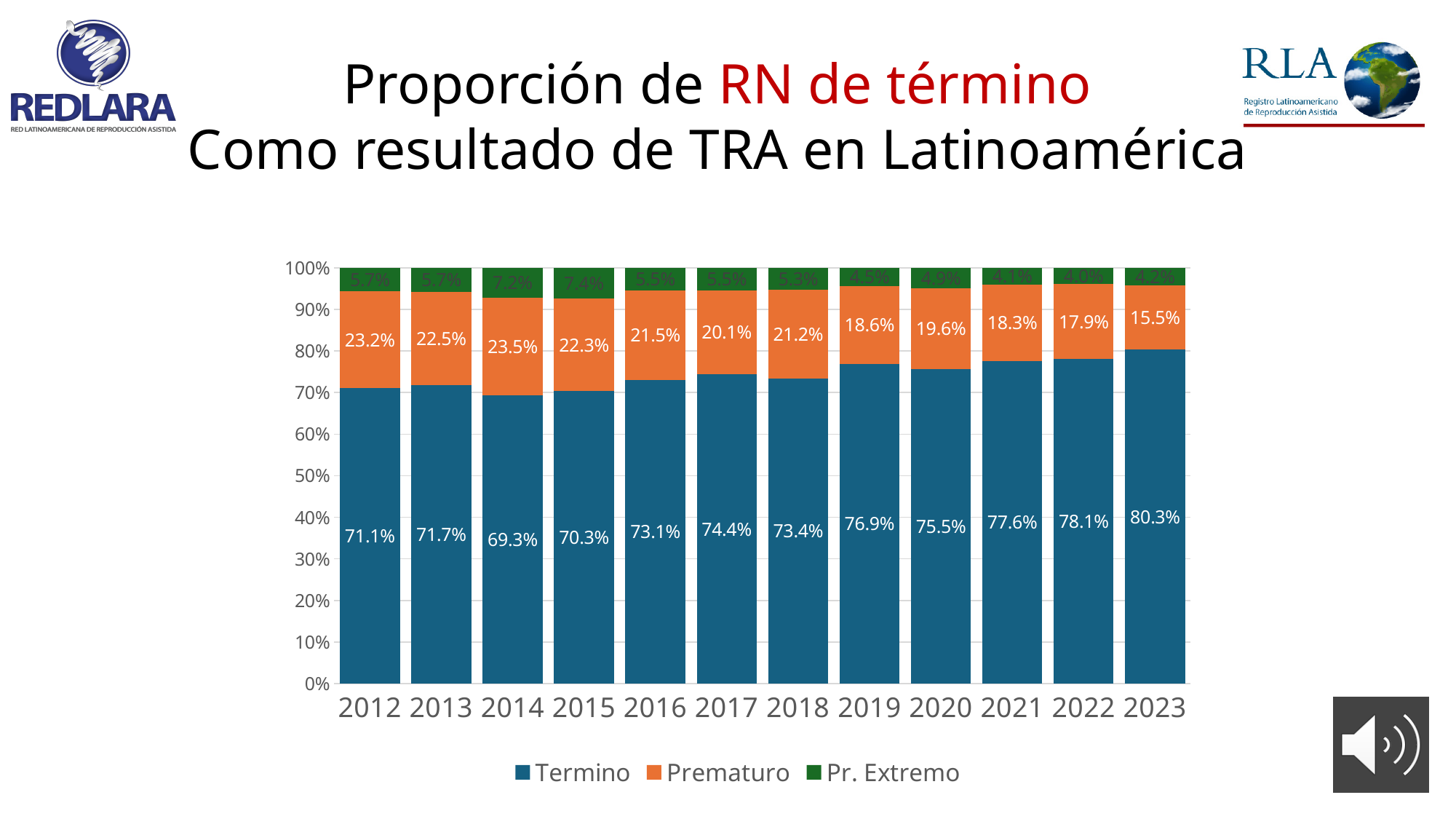
What is the Prematuro value for 2014? 23.5% Does the Prematuro value generally rise or fall from 2012 to 2023? Fall How many series does the legend list? 3 What is the Pr. Extremo value for 2015? 7.4% What is the difference between the Termino values for 2023 and 2012? 9.2% Is the Termino value for 2019 greater or less than 70%? greater Which year has the highest Termino value? 2023 How many years are shown on the x axis? 12 Which year has the lowest Termino value? 2014 What kind of chart is shown on the slide? Stacked bar chart Which is larger, the Prematuro value for 2013 or for 2022? 2013 What is the Termino value for 2023? 80.3%